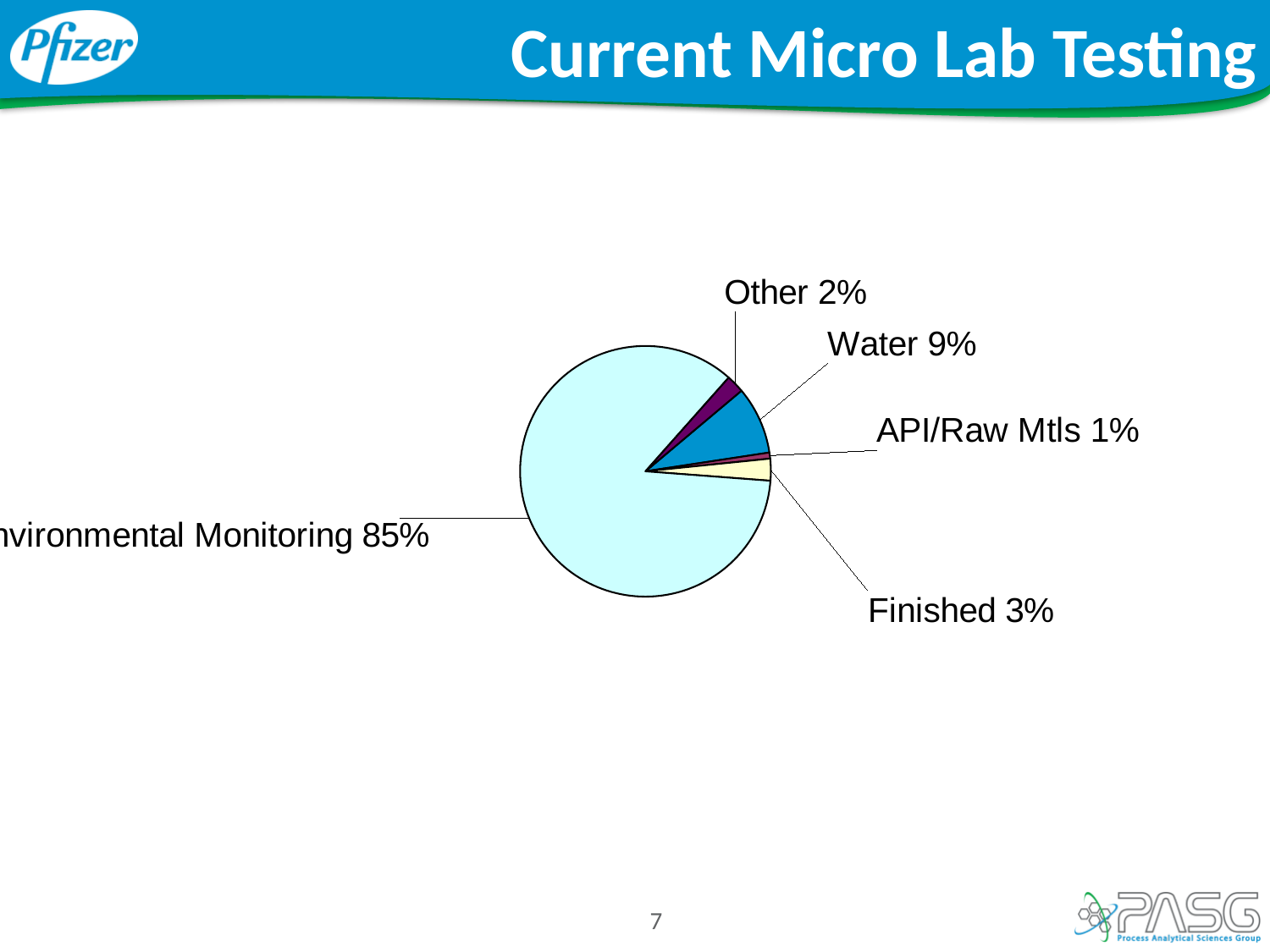
What share of the pie does Other account for? 2% What is the title of the slide containing the pie chart? Current Micro Lab Testing What share of the pie does API/Raw Mtls account for? 1% Which slice of the pie is the largest? Environmental Monitoring Which is larger, the share for Finished or the share for Other? Finished How many slices does the pie chart have? 5 What share of the pie does Finished account for? 3% What kind of chart is shown on the slide? Pie chart Which slice of the pie is the smallest? API/Raw Mtls What is the difference in percentage points between Water and Finished? 6